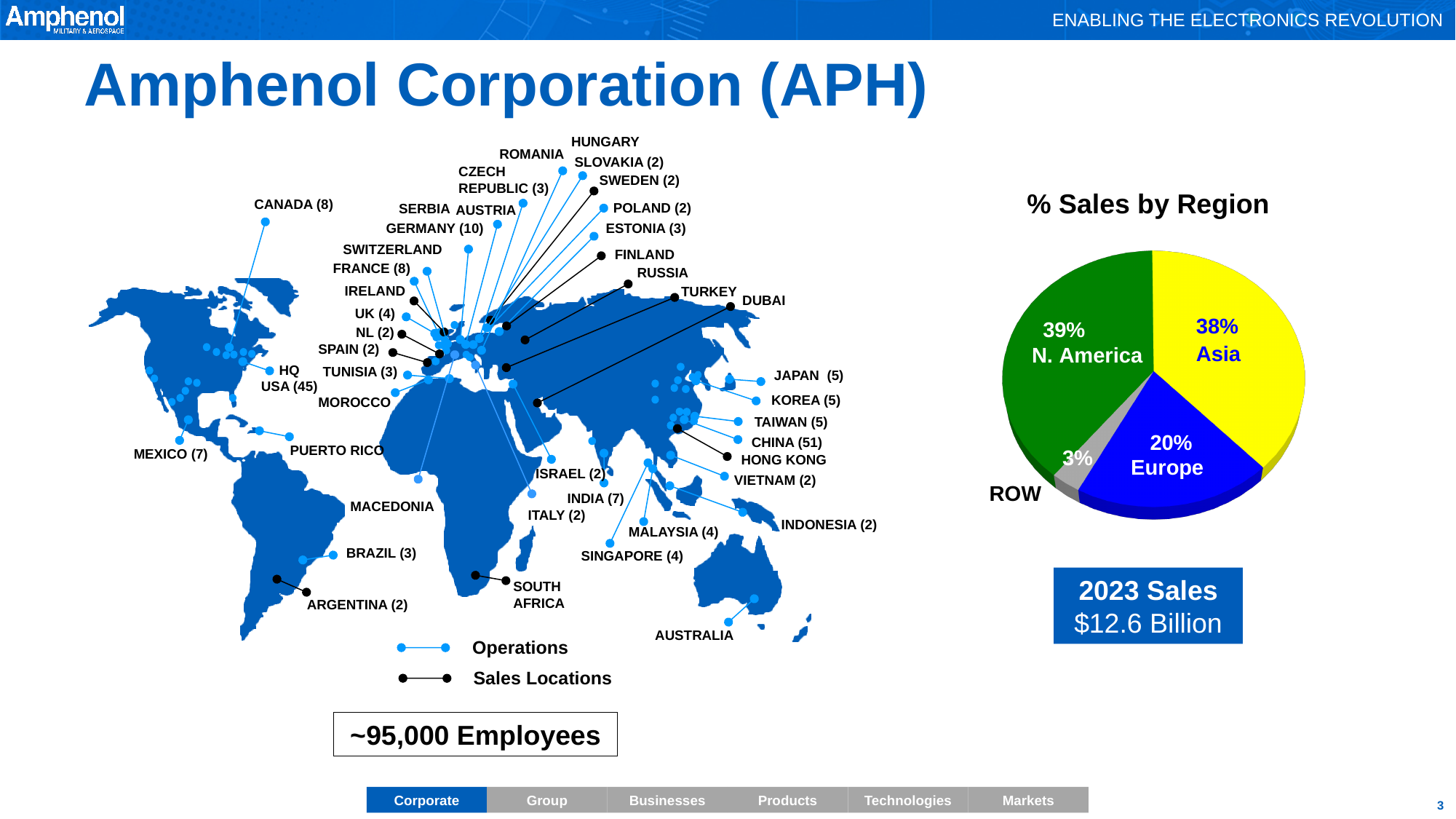
In the % Sales by Region pie chart, what share of sales comes from Europe? 20% In the % Sales by Region pie chart, how many regions (slices) are shown? 4 In the % Sales by Region pie chart, what is the difference in percentage points between the Asia and Europe shares? 18 In the % Sales by Region pie chart, which region has the largest share of sales? N. America What kind of chart is used to show % Sales by Region? pie chart In the % Sales by Region pie chart, which region has the smallest share of sales? ROW In the % Sales by Region pie chart, what share of sales comes from ROW? 3% In the % Sales by Region pie chart, what colour is the Asia slice? yellow In the % Sales by Region pie chart, what share of sales comes from Asia? 38% In the % Sales by Region pie chart, what share of sales comes from N. America? 39% What is the title of the pie chart on the slide? % Sales by Region In the % Sales by Region pie chart, which is larger: the Europe share or the ROW share? Europe